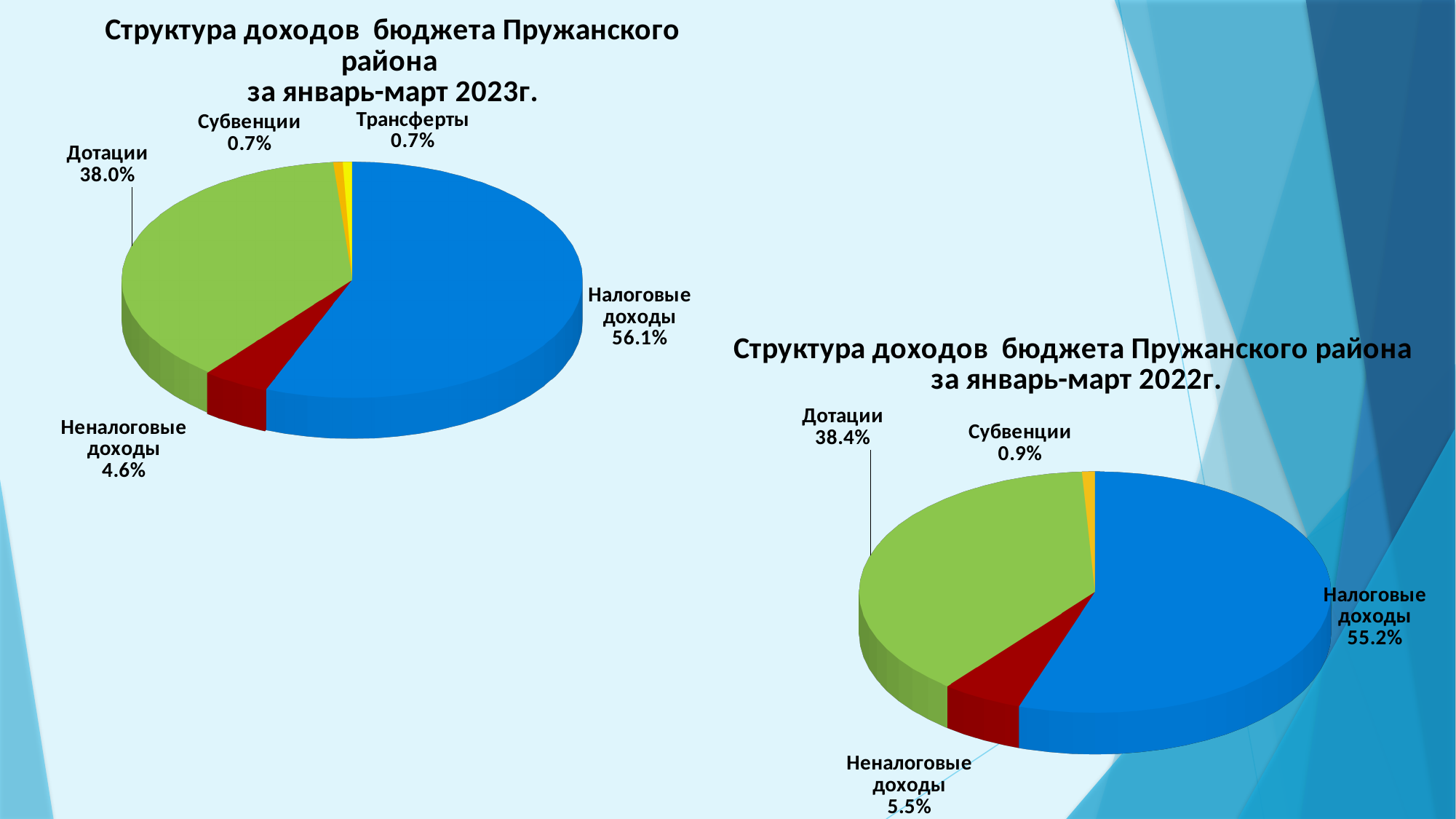
Which is larger: Неналоговые доходы in the 2023 chart or Неналоговые доходы in the 2022 chart? 2022 chart In the chart for January–March 2022, what share do Субвенции have? 0.9% How many slices does the chart for January–March 2023 have? 5 How many slices does the chart for January–March 2022 have? 4 In the chart for January–March 2023, which category has the largest share? Налоговые доходы What type of chart is used for the January–March 2022 data? Pie chart In the chart for January–March 2023, what share do Налоговые доходы have? 56.1% In the chart for January–March 2023, what is the difference between the shares of Налоговые доходы and Дотации? 18.1% In the chart for January–March 2022, what share do Дотации have? 38.4% In the chart for January–March 2023, what share do Неналоговые доходы have? 4.6% In the chart for January–March 2022, what is the difference between the shares of Дотации and Неналоговые доходы? 32.9% In the chart for January–March 2022, which category has the smallest share? Субвенции